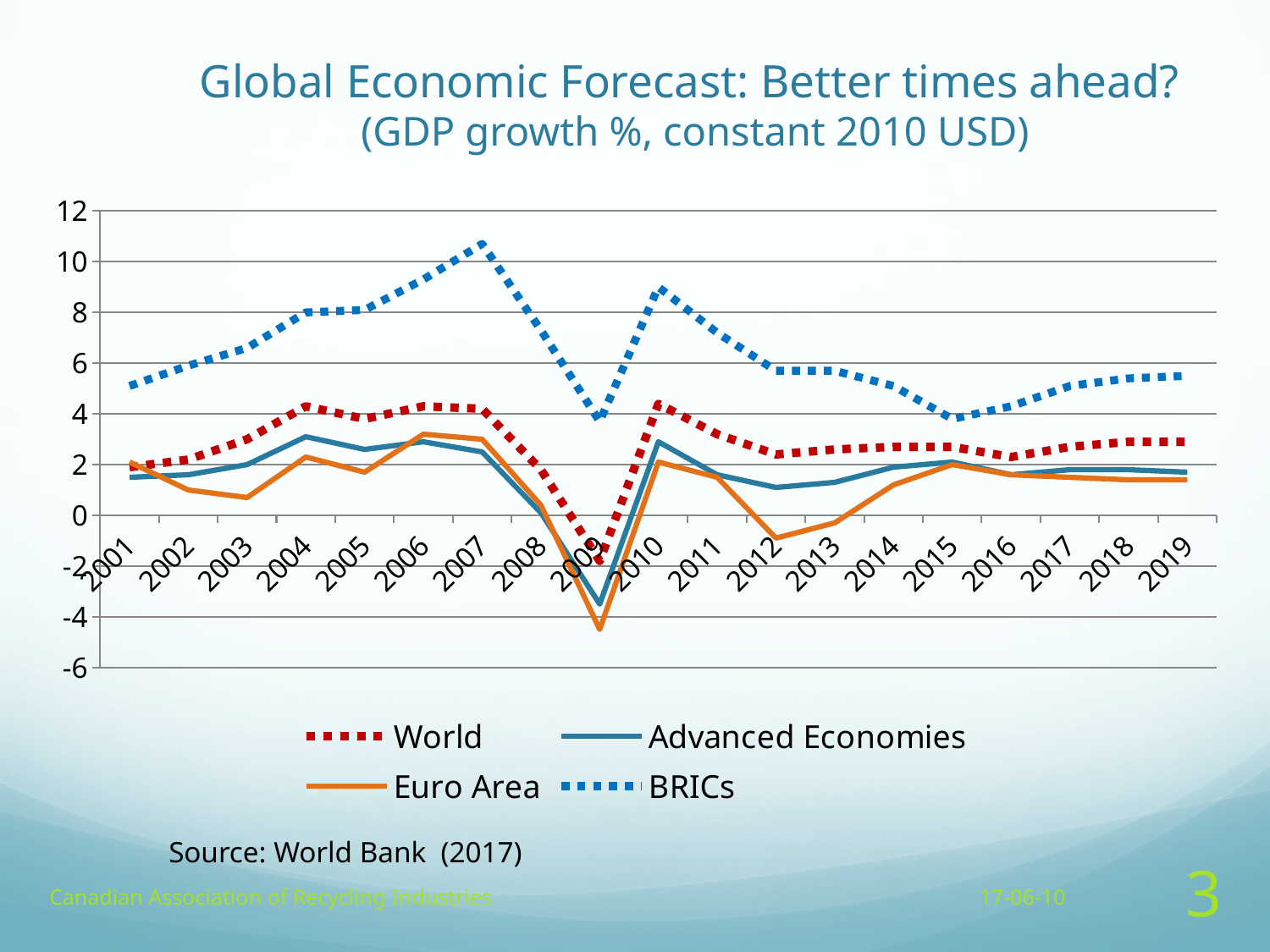
In which year does the BRICs series reach its highest value? 2007 Does the BRICs series rise or fall from 2010 to 2015? fall Is the value for BRICs in 2019 greater or less than 4? greater Which series is drawn as a red dashed line? World Is the value for World in 2009 greater or less than 0? less How many years are shown on the x axis? 19 Which series has the highest value in 2007? BRICs What kind of chart is shown on the slide? line chart How many series does the legend list? 4 Which series has the lowest value in 2009? Euro Area Is the value for BRICs in 2007 greater or less than 10? greater In 2010, which is larger: the value for BRICs or the value for World? BRICs